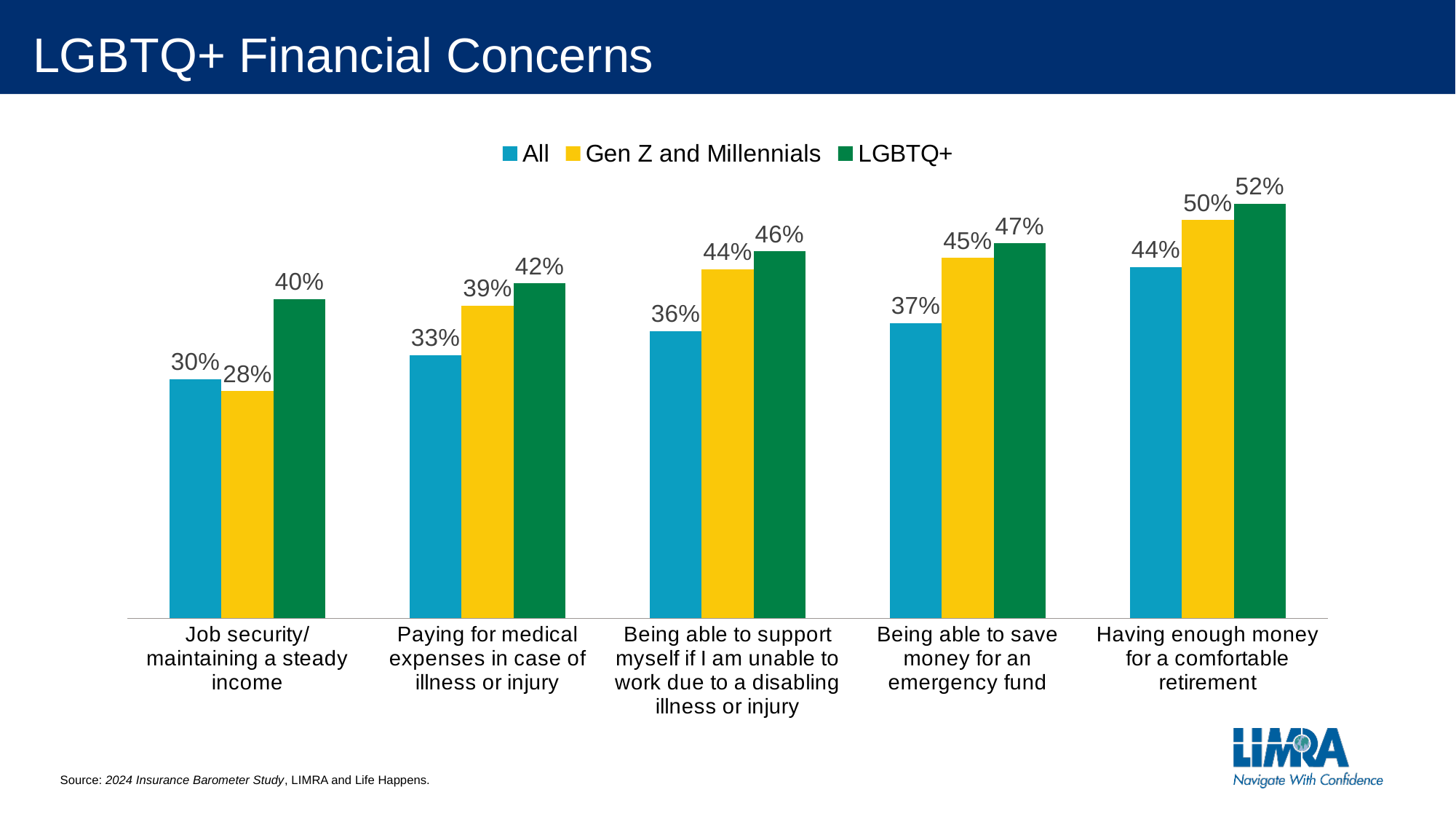
What is the difference between the LGBTQ+ and 'All' values for 'Job security/maintaining a steady income'? 10% For 'Job security/maintaining a steady income', which is larger: the 'All' value or the 'Gen Z and Millennials' value? All Which category has the highest LGBTQ+ value? Having enough money for a comfortable retirement What is the 'All' value for 'Being able to support myself if I am unable to work due to a disabling illness or injury'? 36% What is the LGBTQ+ value for 'Job security/maintaining a steady income'? 40% What is the 'Gen Z and Millennials' value for 'Having enough money for a comfortable retirement'? 50% Do the LGBTQ+ values rise or fall from left to right across the categories? Rise How many categories are shown on the x axis? 5 What kind of chart is shown on the slide? Bar chart What colour represents the LGBTQ+ series in the legend? Green How many series does the legend list? 3 Which category has the lowest 'Gen Z and Millennials' value? Job security/maintaining a steady income